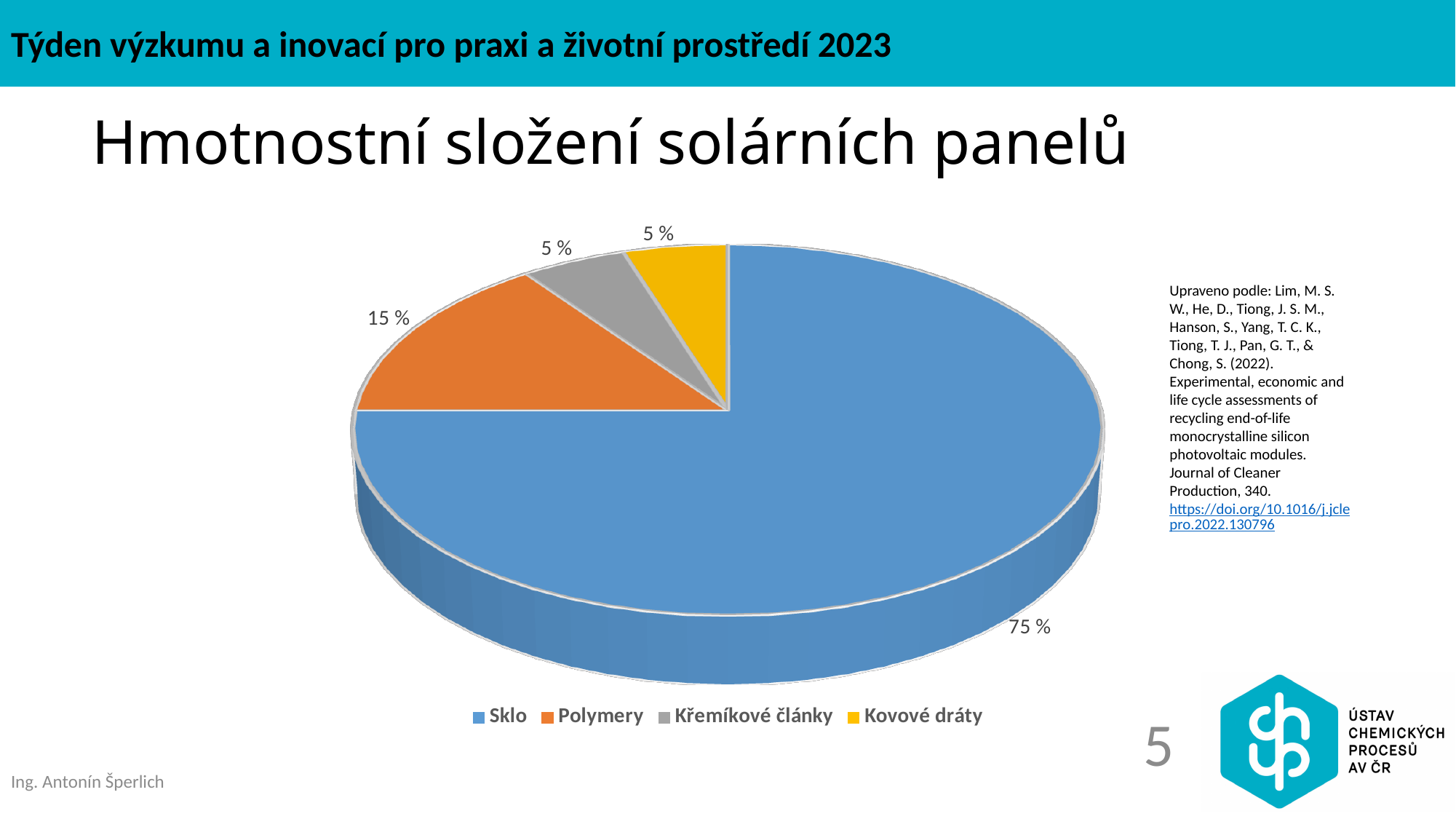
Which category has the largest share of the pie? Sklo What is the title of the slide containing the chart? Hmotnostní složení solárních panelů What is the difference between the shares of Sklo and Polymery? 60 % What share of the pie does Polymery represent? 15 % What share of the pie does Sklo represent? 75 % What share of the pie does Křemíkové články represent? 5 % What colour is the Polymery slice in the pie chart? Orange What kind of chart is shown on the slide? Pie chart Which has a larger share, Polymery or Křemíkové články? Polymery How many categories does the pie chart show? 4 What is the difference between the shares of Polymery and Kovové dráty? 10 % What share of the pie does Kovové dráty represent? 5 %